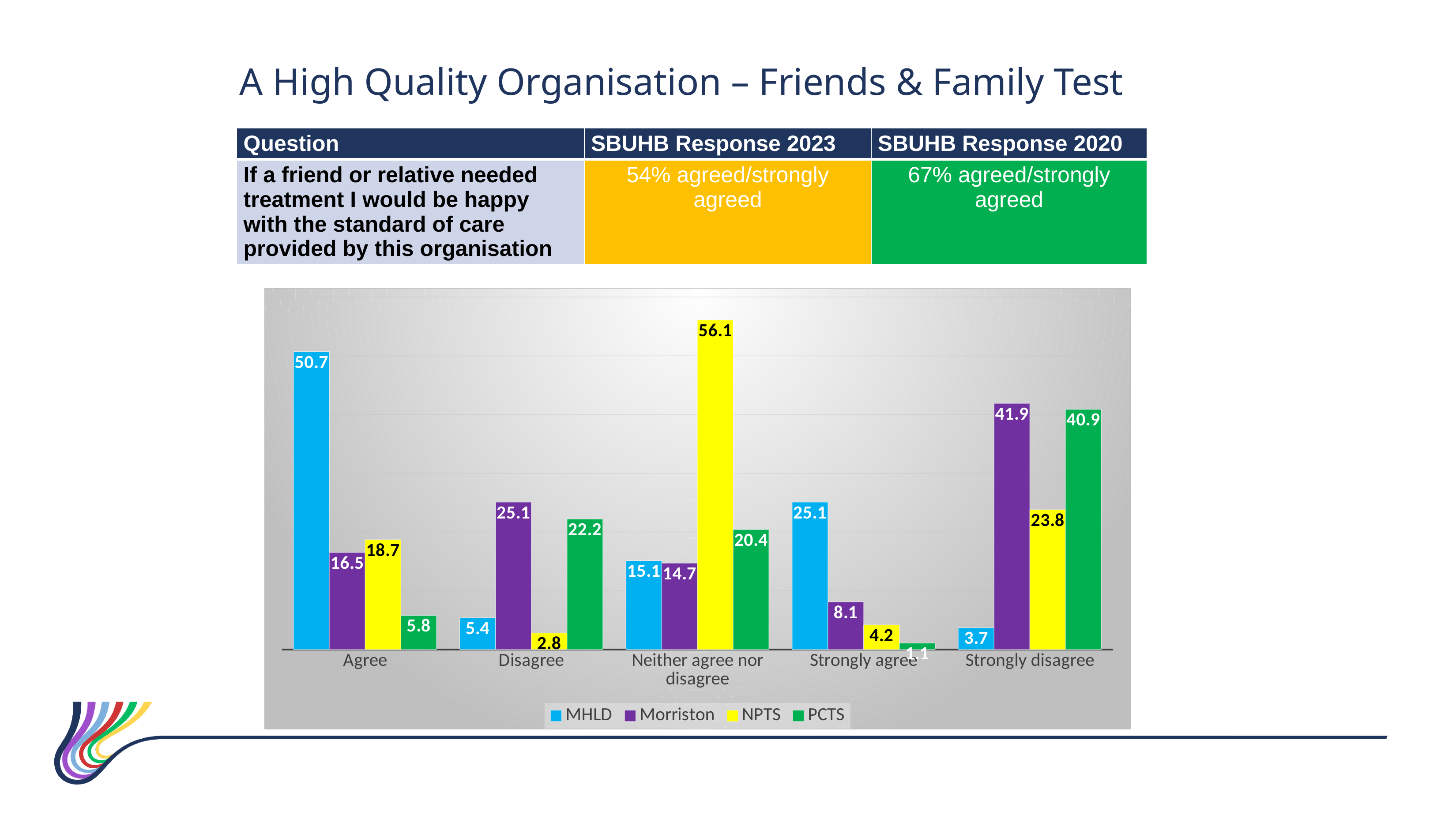
What is the PCTS value for Disagree? 22.2 What is the Morriston value for Strongly disagree? 41.9 How many series does the legend list? 4 What is the difference between the MHLD and Morriston values for Agree? 34.2 What kind of chart is shown on the slide? Bar chart What is the difference between the Morriston and PCTS values for Strongly disagree? 1.0 What is the MHLD value for Agree? 50.7 How many categories are shown on the x axis? 5 Which series has the lowest value for Agree? PCTS What is the NPTS value for Neither agree nor disagree? 56.1 Which series has the highest value for Strongly agree? MHLD Which is larger for Disagree, the Morriston value or the PCTS value? Morriston